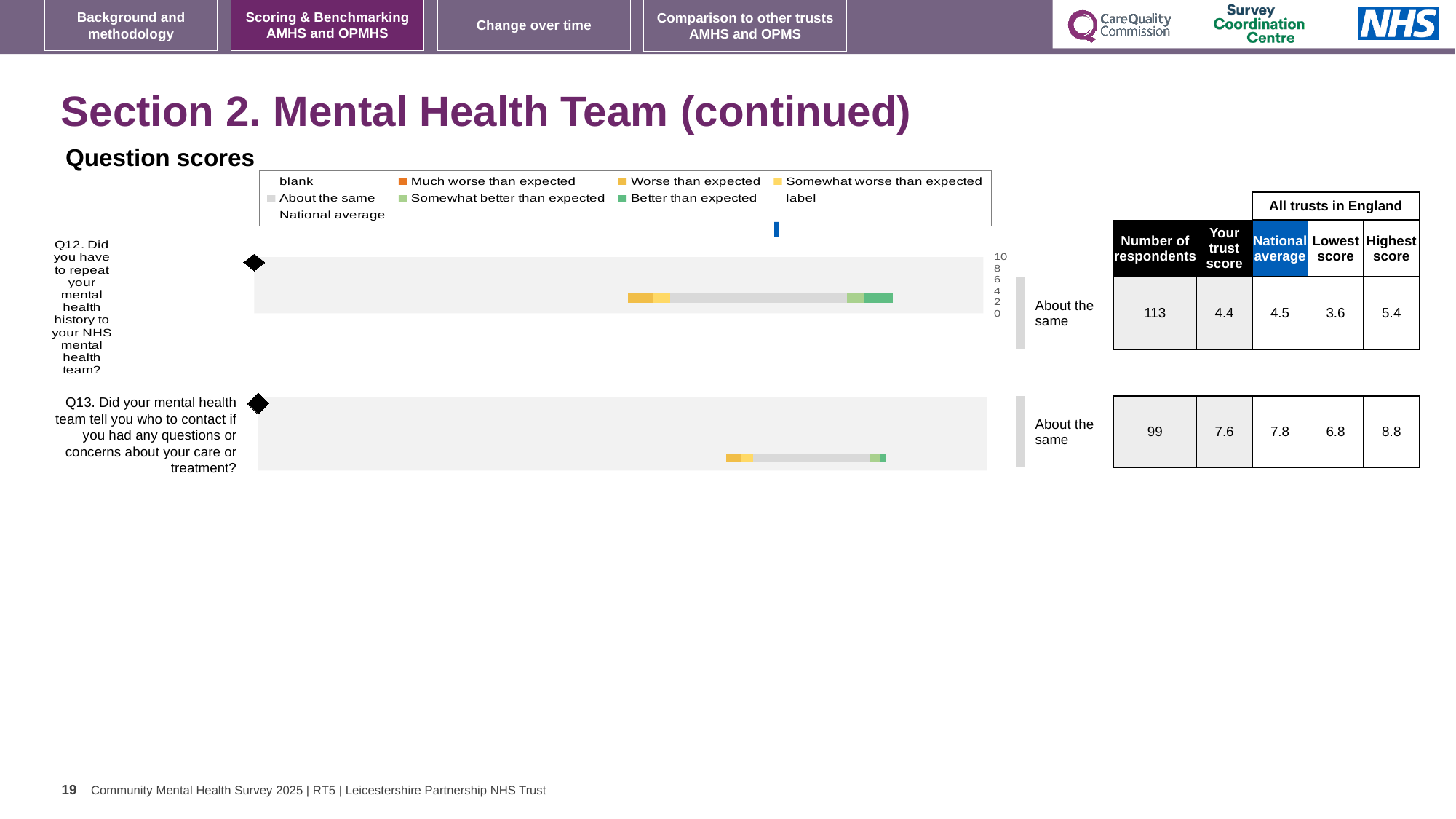
What kind of chart is used to show the question scores for Q12 and Q13? Bar chart What is the difference between the national average and the trust score for Q12? 0.1 How many respondents answered Q12? 113 Which question has the higher trust score, Q12 or Q13? Q13 How many questions are plotted as bars on the slide? 2 What is the difference between the highest score and the lowest score for Q12? 1.8 What benchmark category is shown next to the Q12 bar? About the same For Q13, which is larger: the trust score or the national average? National average What is the highest score among all trusts in England for Q13? 8.8 What is the 'Your trust score' value for Q12? 4.4 What is the national average score for Q13? 7.8 Which legend entry is shown in orange? Much worse than expected